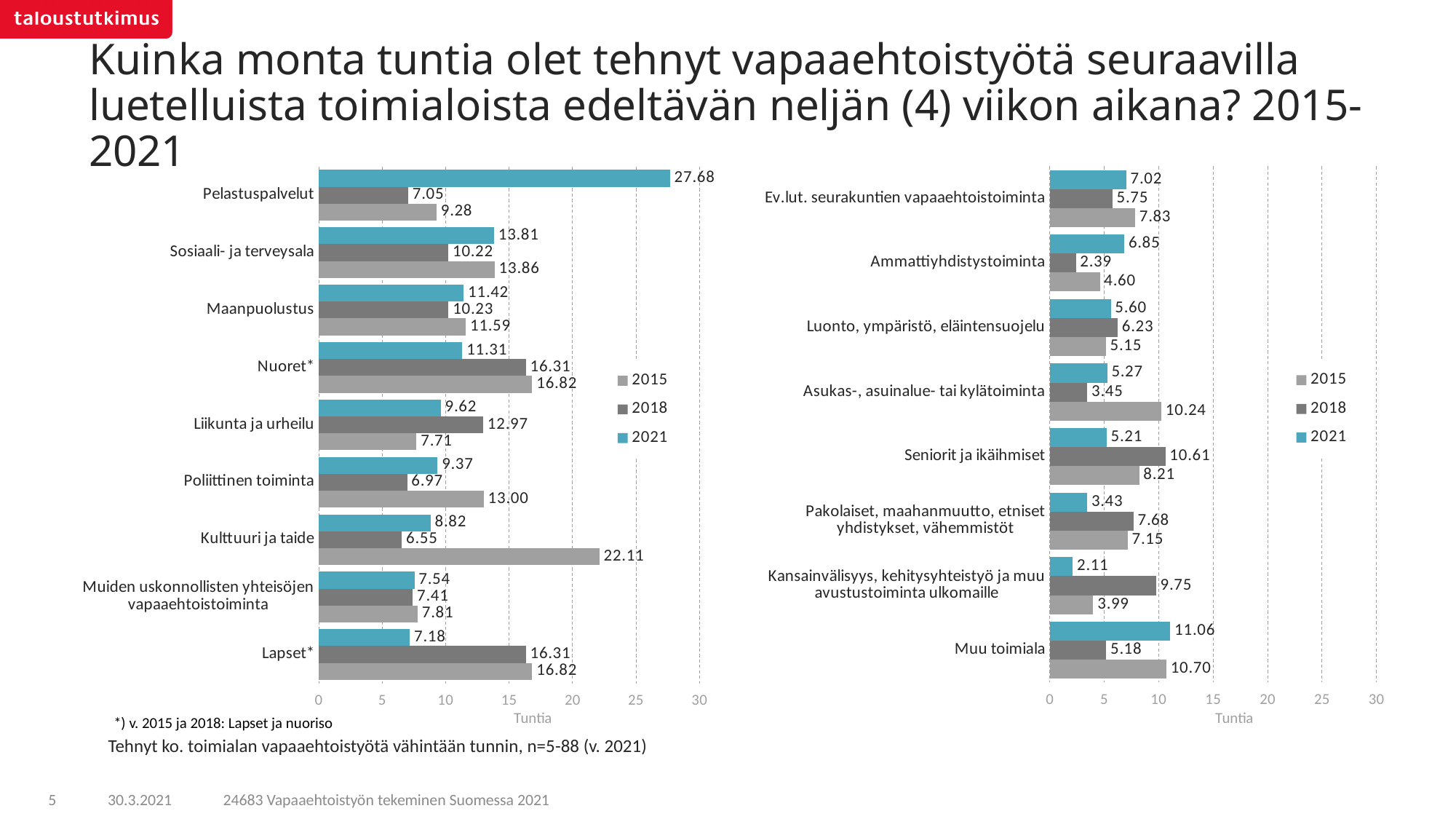
In the right chart, which is larger for Muu toimiala: the 2021 value or the 2015 value? 2021 In the left chart, which category has the highest 2021 value? Pelastuspalvelut In the right chart, is the 2015 value for Asukas-, asuinalue- tai kylätoiminta greater or less than 10? greater In the right chart, what is the 2021 value for Kansainvälisyys, kehitysyhteistyö ja muu avustustoiminta ulkomaille? 2.11 What type of chart is the left chart? bar chart In the right chart, which category has the lowest 2018 value? Ammattiyhdistystoiminta How many series does the legend of the left chart list? 3 How many categories are shown in the right chart? 8 In the left chart, what is the 2021 value for Pelastuspalvelut? 27.68 In the right chart, what is the 2018 value for Seniorit ja ikäihmiset? 10.61 In the left chart, what is the difference between the 2015 and 2018 values for Poliittinen toiminta? 6.03 In the left chart, what is the 2015 value for Kulttuuri ja taide? 22.11